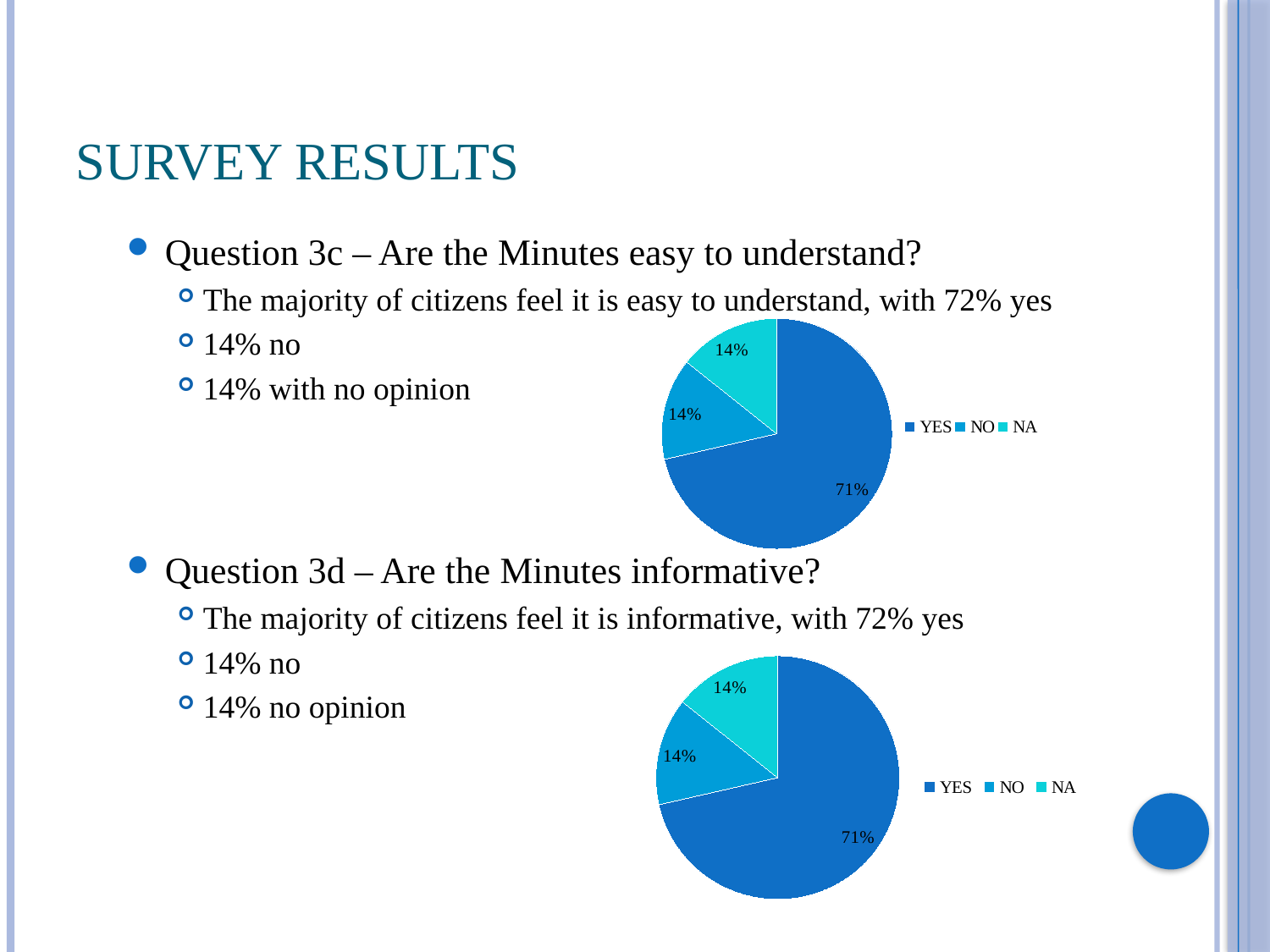
In the upper pie chart, which is larger, YES or NO? YES How many slices does the upper pie chart have? 3 In the upper pie chart, what percentage is shown for YES? 71% In the lower pie chart, what percentage is shown for YES? 71% What are the legend entries of the upper pie chart? YES, NO, NA In the lower pie chart, which category has the largest slice? YES In the upper pie chart, what percentage is shown for NO? 14% How many entries does the legend of the lower pie chart list? 3 In the lower pie chart, what is the difference between the YES and NO percentages? 57% In the upper pie chart, which category has the largest slice? YES In the lower pie chart, what percentage is shown for NA? 14% What type of chart is the upper chart on the slide? pie chart